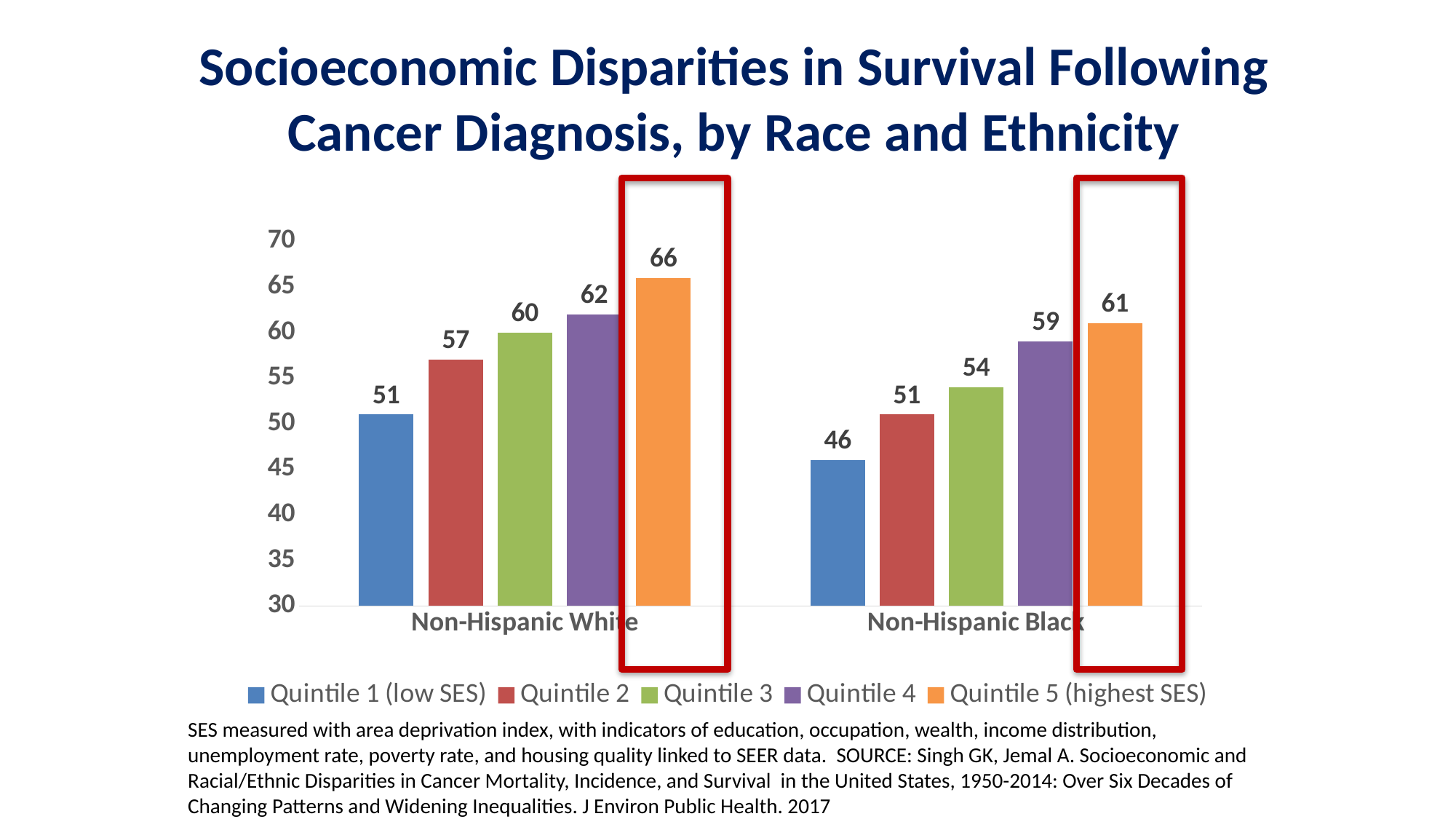
Which quintile has the highest value in the Non-Hispanic Black group? Quintile 5 (highest SES) Within each race/ethnicity group, do the values rise or fall from Quintile 1 to Quintile 5? Rise What is the difference between the Quintile 4 values for Non-Hispanic White and Non-Hispanic Black? 3 What is the value for Quintile 1 (low SES) in the Non-Hispanic Black group? 46 Which quintile has the lowest value in the Non-Hispanic White group? Quintile 1 (low SES) Which is larger: Quintile 2 for Non-Hispanic White or Quintile 2 for Non-Hispanic Black? Non-Hispanic White What is the difference between Quintile 5 (highest SES) and Quintile 1 (low SES) in the Non-Hispanic White group? 15 What kind of chart is shown on the slide? Bar chart What is the value for Quintile 5 (highest SES) in the Non-Hispanic White group? 66 How many series does the legend list? 5 How many race/ethnicity categories are shown on the x axis? 2 What is the value for Quintile 3 in the Non-Hispanic Black group? 54